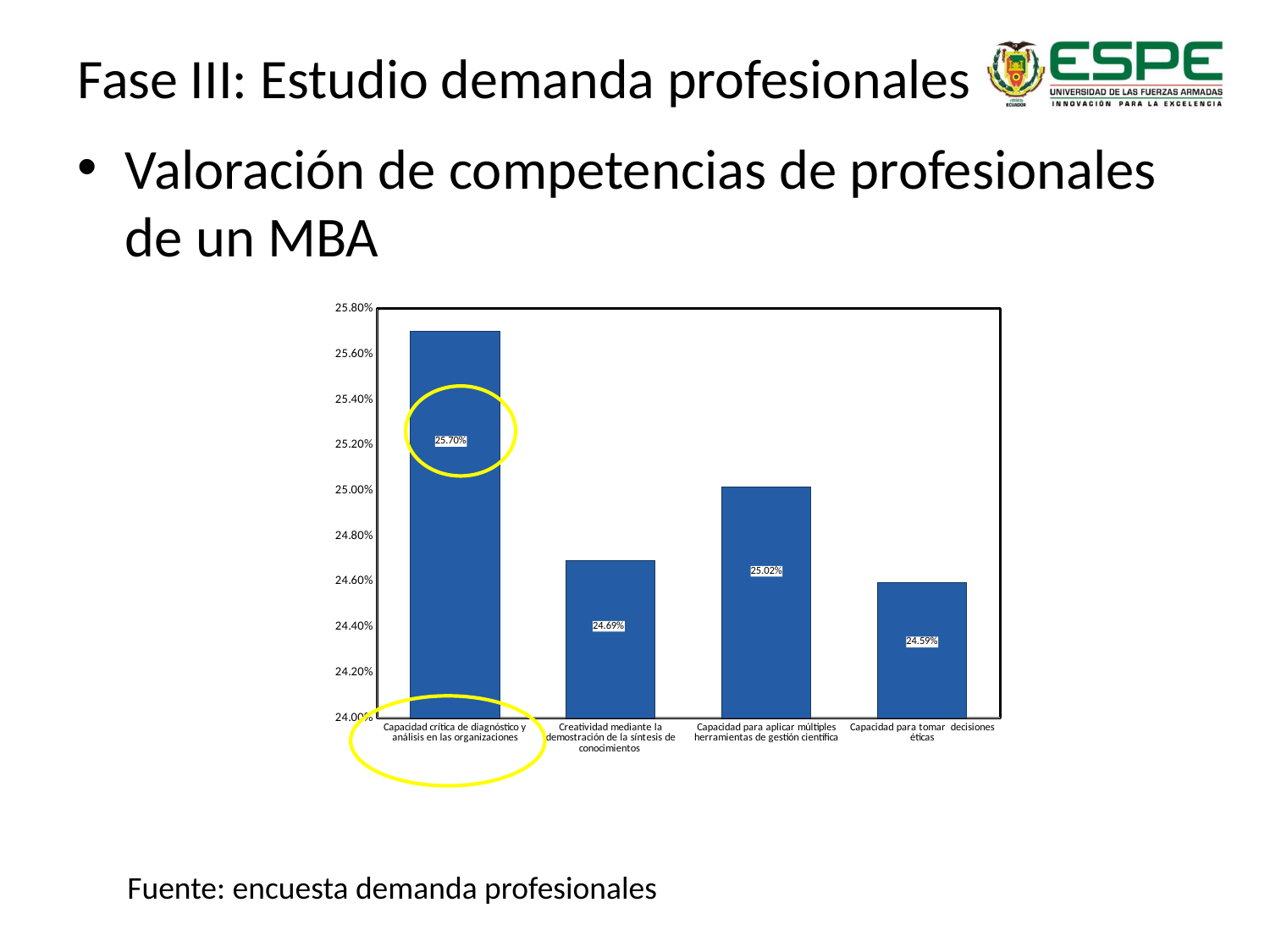
What is the value for 'Creatividad mediante la demostración de la síntesis de conocimientos'? 24.69% What is the value for 'Capacidad para tomar decisiones éticas'? 24.59% What kind of chart is shown on the slide? Bar chart How many categories are shown in the chart? 4 Which is larger: the value for 'Capacidad para aplicar múltiples herramientas de gestión científica' or for 'Creatividad mediante la demostración de la síntesis de conocimientos'? Capacidad para aplicar múltiples herramientas de gestión científica What is the difference between the values for 'Capacidad para aplicar múltiples herramientas de gestión científica' and 'Creatividad mediante la demostración de la síntesis de conocimientos'? 0.33 percentage points What is the value for 'Capacidad para aplicar múltiples herramientas de gestión científica'? 25.02% What is the difference between the values for 'Capacidad crítica de diagnóstico y análisis en las organizaciones' and 'Capacidad para tomar decisiones éticas'? 1.11 percentage points What is the value for 'Capacidad crítica de diagnóstico y análisis en las organizaciones'? 25.70% Which category has the lowest value? Capacidad para tomar decisiones éticas Is the value for 'Capacidad para tomar decisiones éticas' greater or less than 25.00%? less Which category has the highest value? Capacidad crítica de diagnóstico y análisis en las organizaciones